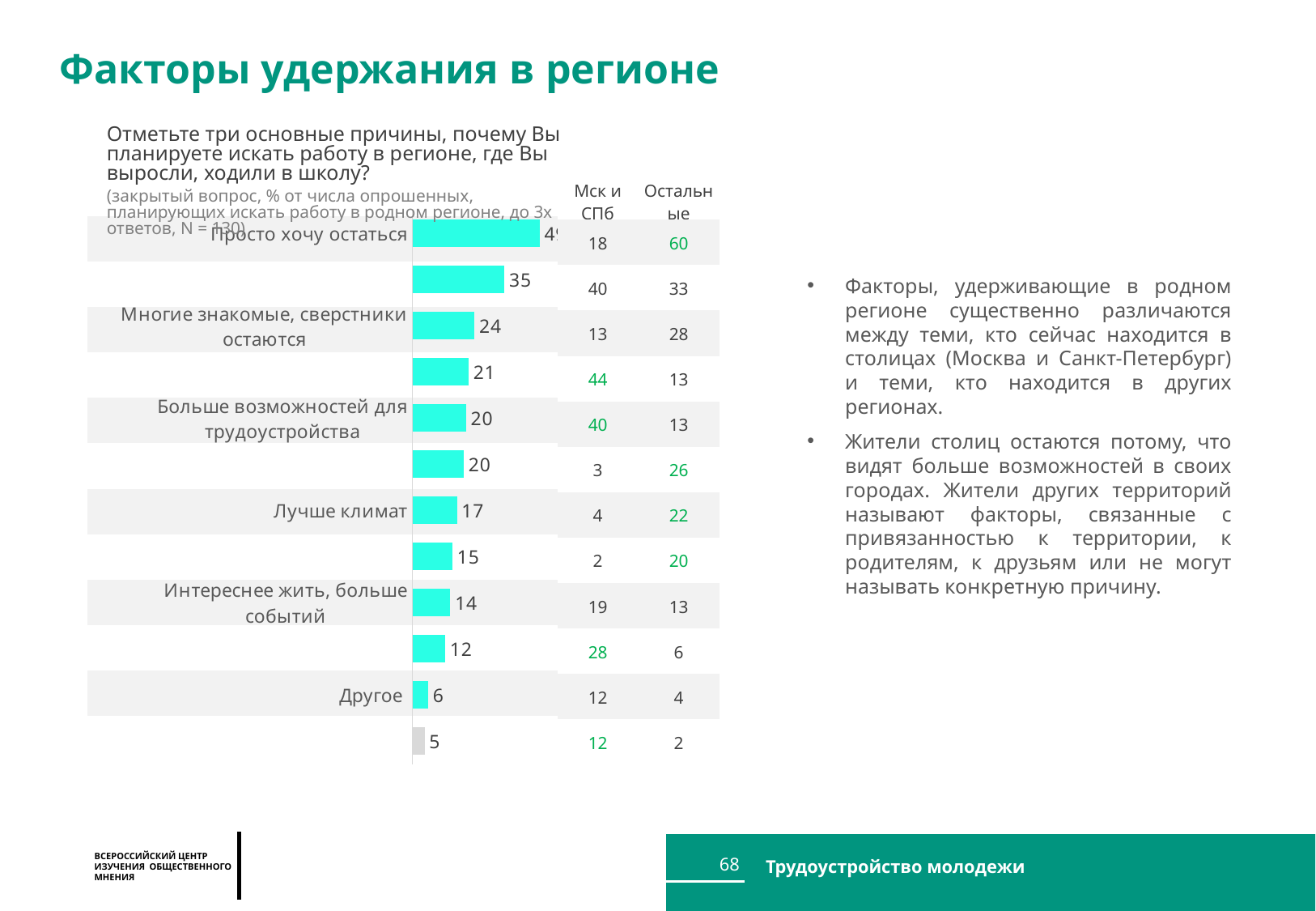
What is the value for "Другое"? 6 What is the value for "Лучше климат"? 17 What kind of chart is shown on the slide? Bar chart What is the value for "Больше возможностей для трудоустройства"? 20 In the table next to the chart, what is the "Мск и СПб" value for "Больше возможностей для трудоустройства"? 40 How many bars are shown on the chart? 12 Which category has the highest value on the chart? Просто хочу остаться What is the value for "Многие знакомые, сверстники остаются"? 24 What is the value for "Интереснее жить, больше событий"? 14 What is the difference between the values for "Многие знакомые, сверстники остаются" and "Лучше климат"? 7 What is the smallest value shown on the chart? 5 Which is larger: the value for "Больше возможностей для трудоустройства" or for "Интереснее жить, больше событий"? Больше возможностей для трудоустройства